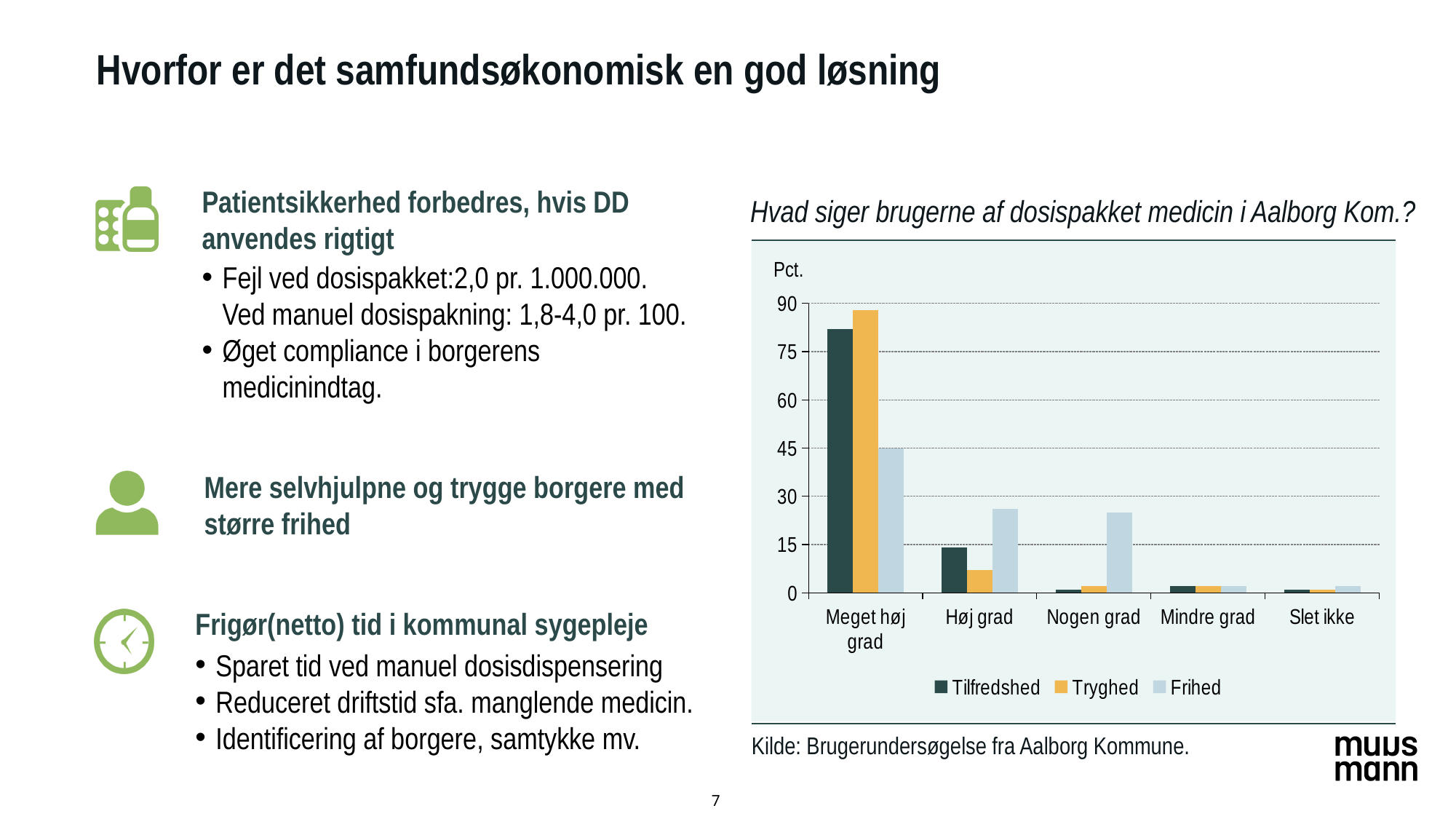
Is the value for Frihed in the Høj grad category greater or less than 30? less How many categories are shown on the x axis of the chart? 5 Does the Tilfredshed series rise or fall moving from Meget høj grad to Slet ikke along the x axis? fall What kind of chart is shown on the slide? bar chart What is the title of the chart? Hvad siger brugerne af dosispakket medicin i Aalborg Kom.? Which category has the highest value for the Tryghed series? Meget høj grad In the Meget høj grad category, which is larger: Tilfredshed or Tryghed? Tryghed Is the value for Tryghed in the Meget høj grad category greater or less than 75? greater Which category has the highest value for the Frihed series? Meget høj grad Is the value for Tryghed in the Høj grad category greater or less than 15? less How many series does the chart legend list? 3 In the Høj grad category, which is larger: Tryghed or Frihed? Frihed